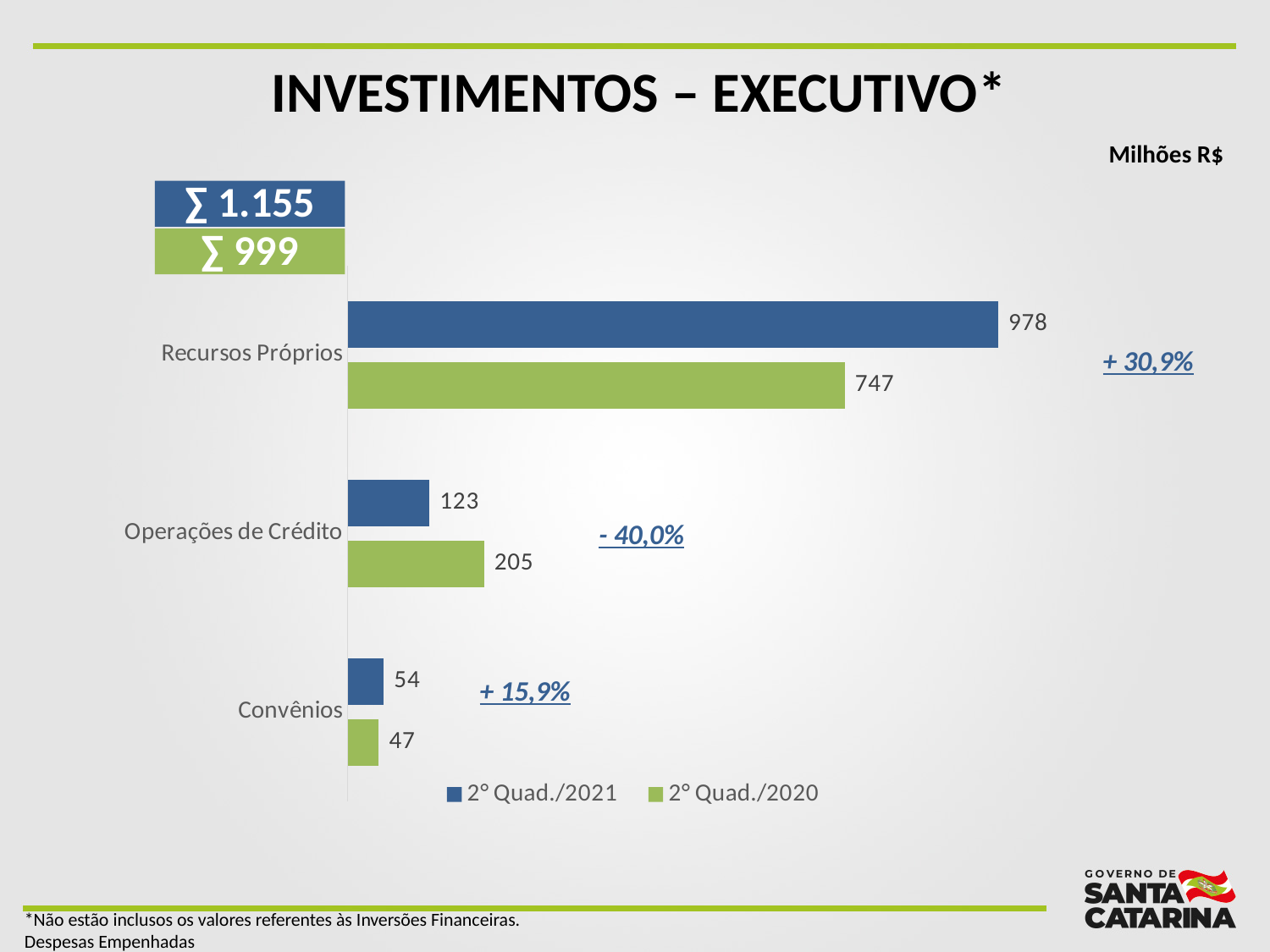
What is the total (∑) shown for 2° Quad./2020? 999 What is the value for Convênios in 2° Quad./2021? 54 Which category has the highest value in 2° Quad./2020? Recursos Próprios Which category has the lowest value in 2° Quad./2021? Convênios Which is larger for Operações de Crédito: the 2° Quad./2021 value or the 2° Quad./2020 value? 2° Quad./2020 What is the value for Operações de Crédito in 2° Quad./2020? 205 What is the difference between the 2° Quad./2021 and 2° Quad./2020 values for Recursos Próprios? 231 What kind of chart is shown on the slide? Bar chart What is the value for Recursos Próprios in 2° Quad./2021? 978 How many series does the legend list? 2 What percentage change is shown for Operações de Crédito? - 40,0% How many categories are shown on the chart? 3